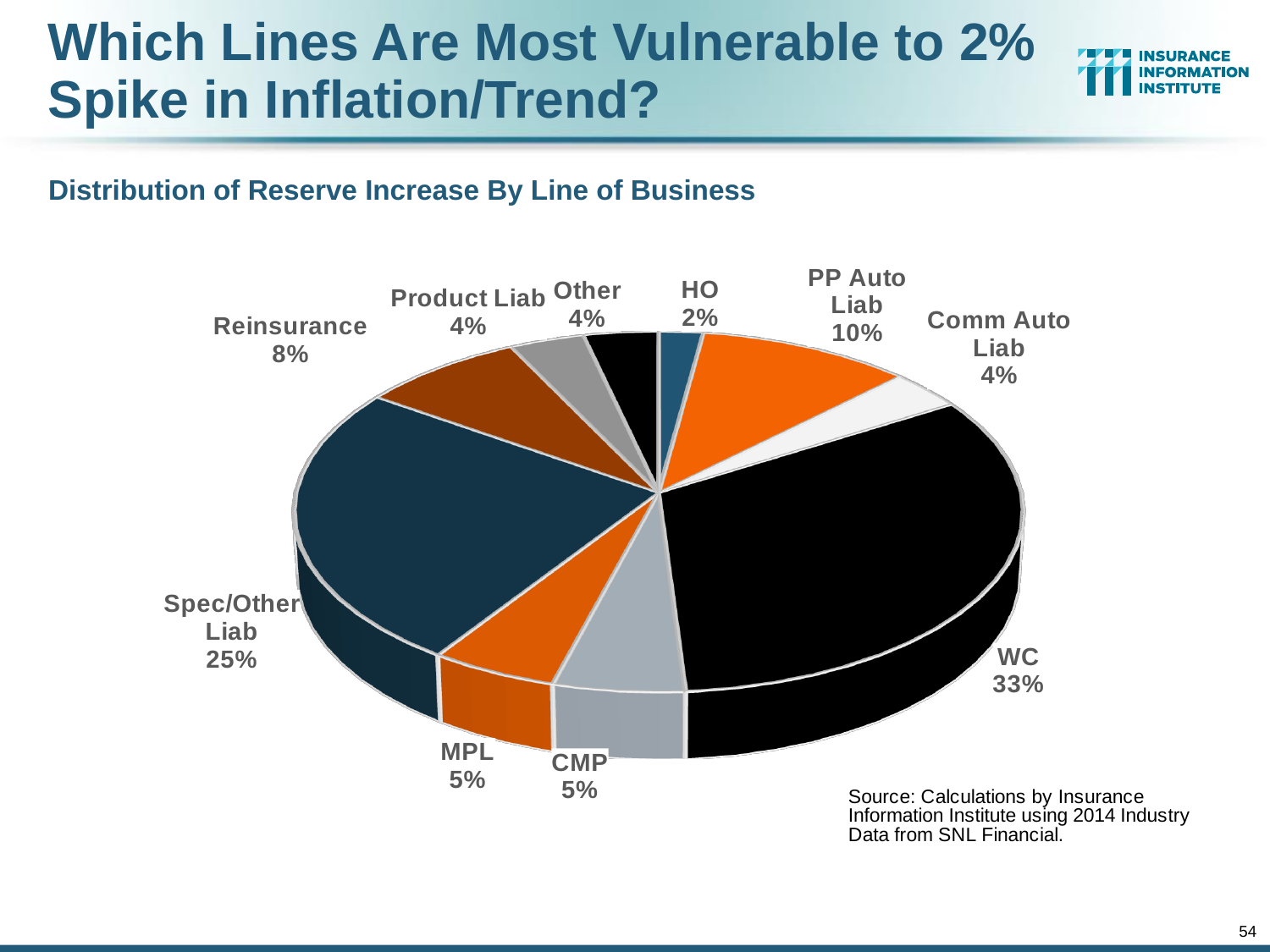
What share of the reserve increase is attributed to WC? 33% What is the difference in percentage points between the WC share and the Spec/Other Liab share? 8 What share of the reserve increase is attributed to Reinsurance? 8% Which has a larger share of the reserve increase, PP Auto Liab or Reinsurance? PP Auto Liab What share of the reserve increase is attributed to PP Auto Liab? 10% What is the subtitle of the chart on the slide? Distribution of Reserve Increase By Line of Business How many lines of business (slices) are shown in the pie chart? 10 What is the combined share of MPL and CMP? 10% What kind of chart is shown on the slide? Pie chart Which line of business has the largest share of the reserve increase? WC What share of the reserve increase is attributed to Spec/Other Liab? 25% Which line of business has the smallest share of the reserve increase? HO